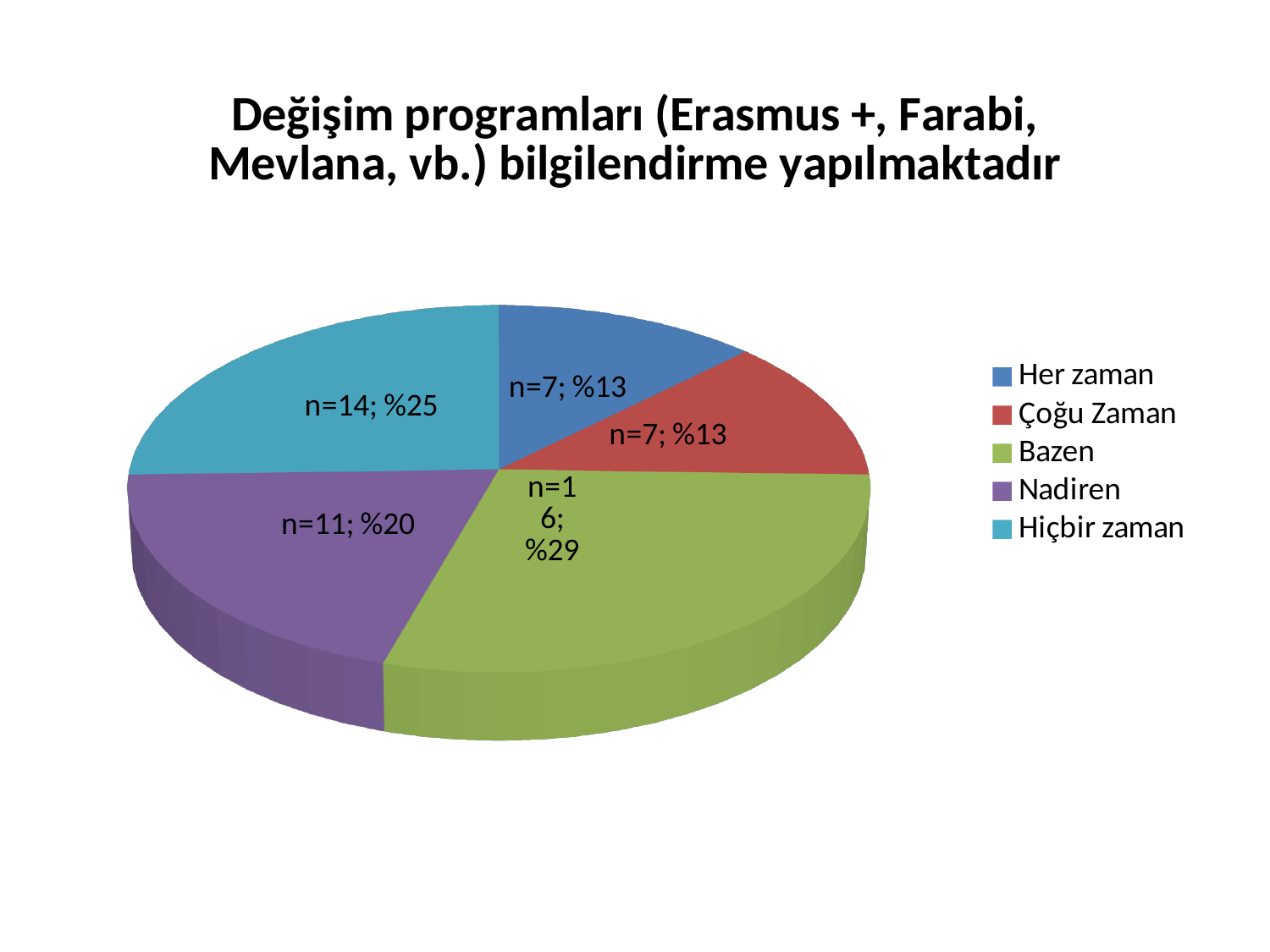
What is the count (n) for the Bazen slice? n=16 How many categories does the legend list? 5 What percentage is shown for the Her zaman slice? %13 What percentage is shown for the Hiçbir zaman slice? %25 What kind of chart is shown on the slide? Pie chart What is the title of the chart? Değişim programları (Erasmus +, Farabi, Mevlana, vb.) bilgilendirme yapılmaktadır Which category has the largest slice? Bazen Which category has the larger count, Nadiren or Hiçbir zaman? Hiçbir zaman What is the difference in count (n) between Bazen and Çoğu Zaman? 9 What is the total count (n) across all slices? 55 What is the count (n) for the Nadiren slice? n=11 Which colour represents the Nadiren category in the legend? Purple